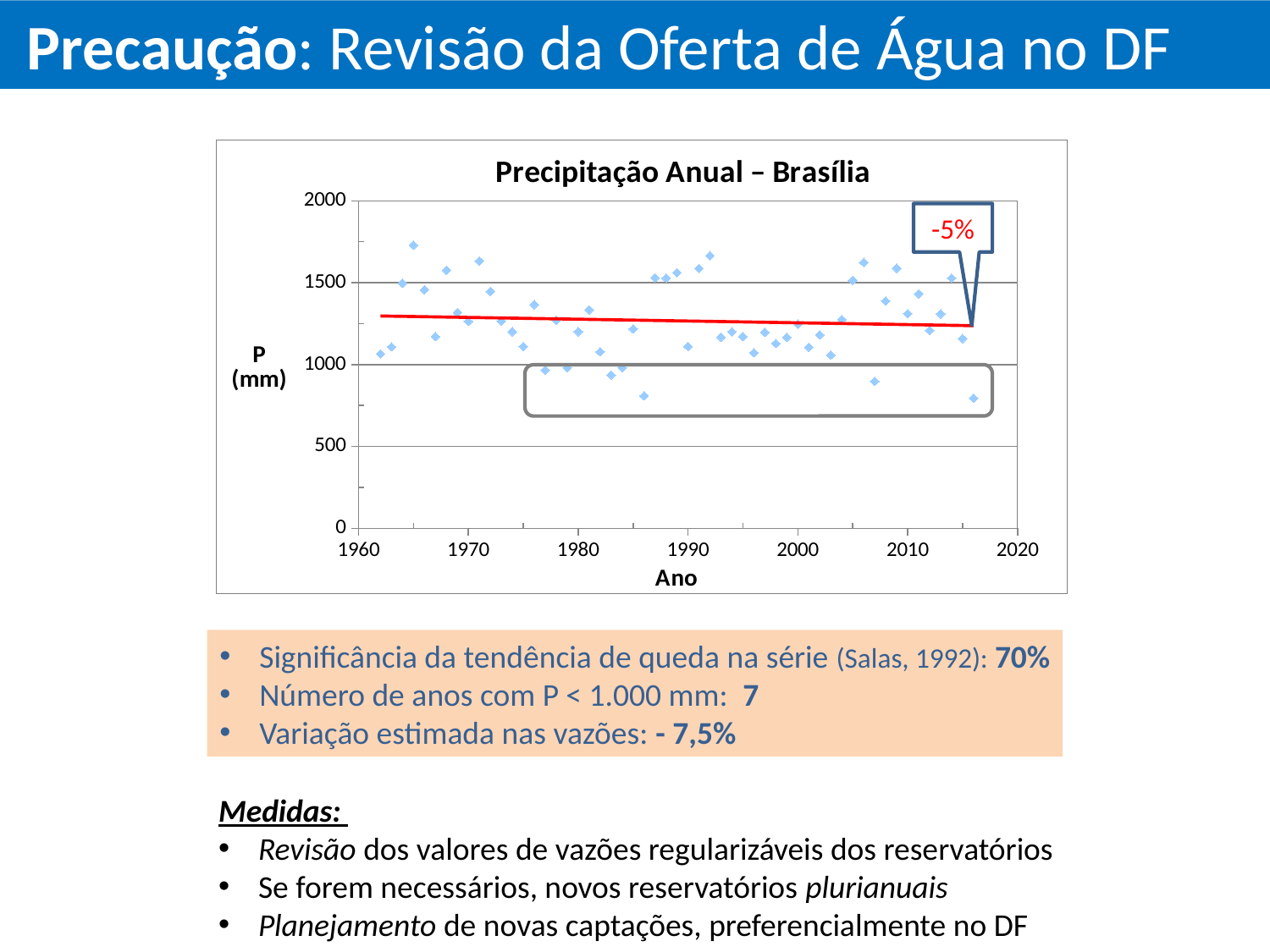
What is the maximum value shown on the vertical axis? 2000 How many plotted points fall below 1000 mm? 7 According to the red trend line, do the precipitation values rise or fall over the years? Fall What percentage change is indicated by the callout on the trend line? -5% What kind of chart is shown on the slide? Scatter chart What is the label of the vertical axis? P (mm) Is the highest plotted precipitation value greater or less than 1500? greater Is the lowest plotted precipitation value greater or less than 1000? less Is the value plotted at the year 1990 greater or less than 1500? less